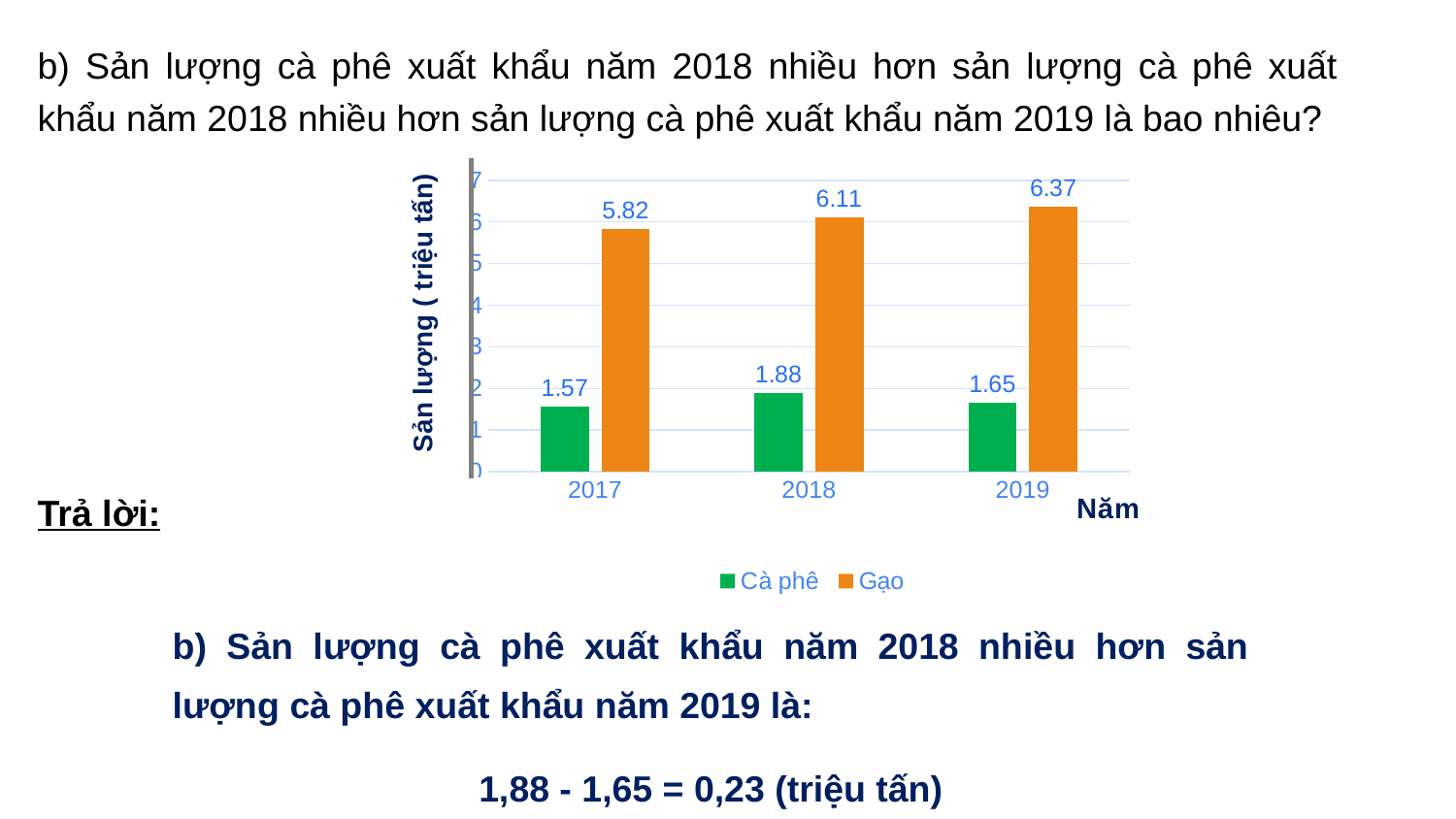
What is the value for Gạo in 2019? 6.37 What is the value for Gạo in 2017? 5.82 In which year is the Cà phê value lowest? 2017 What is the value for Cà phê in 2018? 1.88 How many series does the legend list? 2 How many years are shown on the x axis? 3 What is the value for Cà phê in 2017? 1.57 Which is larger, the Cà phê value in 2018 or in 2019? 2018 What is the difference between the Gạo values for 2019 and 2018? 0.26 In which year is the Gạo value highest? 2019 Does the Gạo series rise or fall from 2017 to 2019? rise What is the difference between the Cà phê values for 2018 and 2019? 0.23